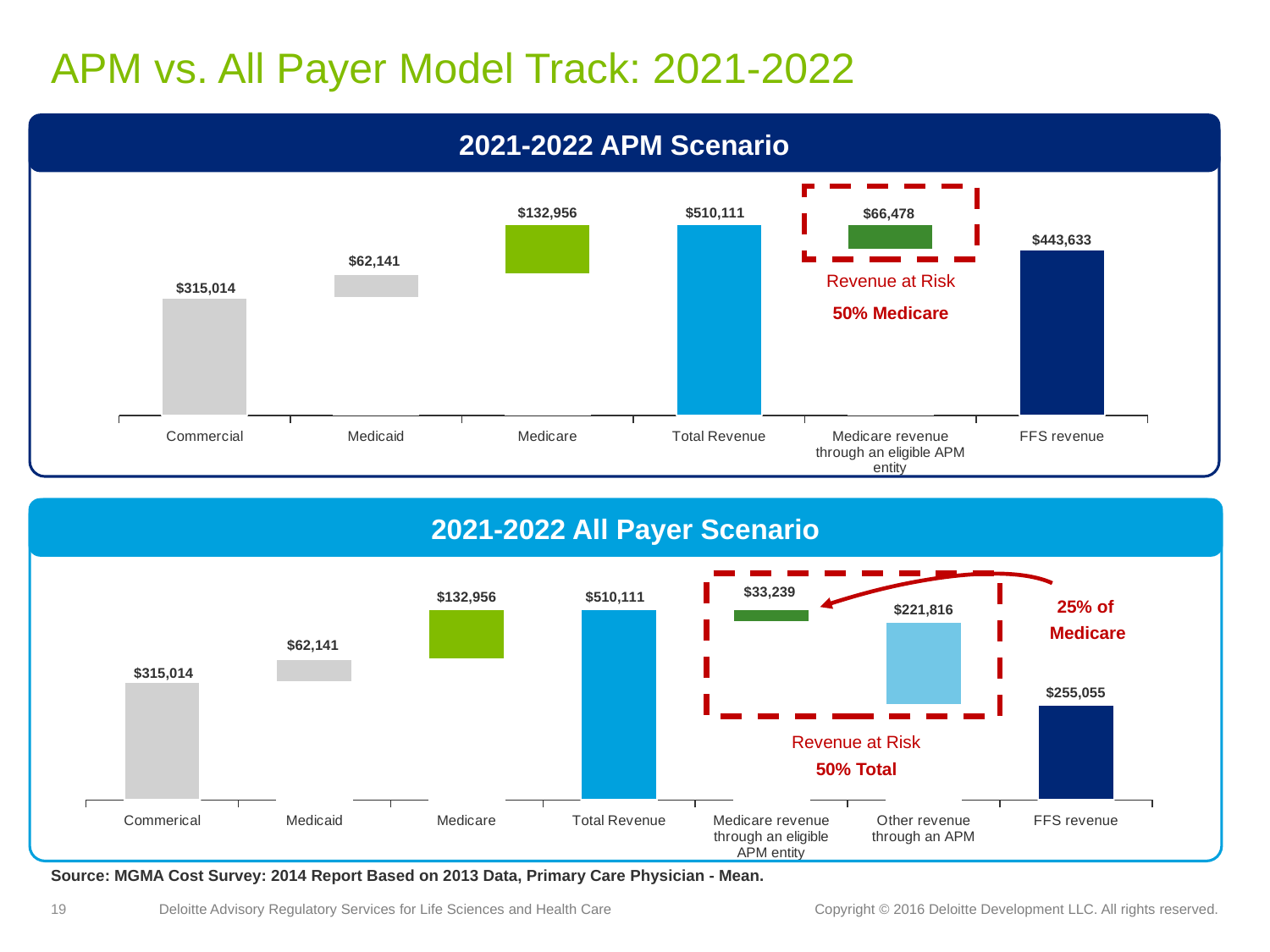
What is the difference between FFS revenue in the 2021-2022 APM Scenario chart and FFS revenue in the 2021-2022 All Payer Scenario chart? $188,578 In the 2021-2022 All Payer Scenario chart, what is the value for Other revenue through an APM? $221,816 In the 2021-2022 All Payer Scenario chart, what is the value for Medicare revenue through an eligible APM entity? $33,239 In the 2021-2022 APM Scenario chart, what is the value for Commercial? $315,014 In the 2021-2022 All Payer Scenario chart, how many categories are shown on the x axis? 7 In the 2021-2022 APM Scenario chart, what is the value for Medicare revenue through an eligible APM entity? $66,478 In the 2021-2022 All Payer Scenario chart, which category has the highest value? Total Revenue In the 2021-2022 APM Scenario chart, what is the difference between Total Revenue and FFS revenue? $66,478 In the 2021-2022 APM Scenario chart, how many categories are shown on the x axis? 6 In the 2021-2022 APM Scenario chart, what is the value for FFS revenue? $443,633 In the 2021-2022 All Payer Scenario chart, which is larger, Medicare or FFS revenue? FFS revenue In the 2021-2022 APM Scenario chart, which category has the lowest value? Medicaid